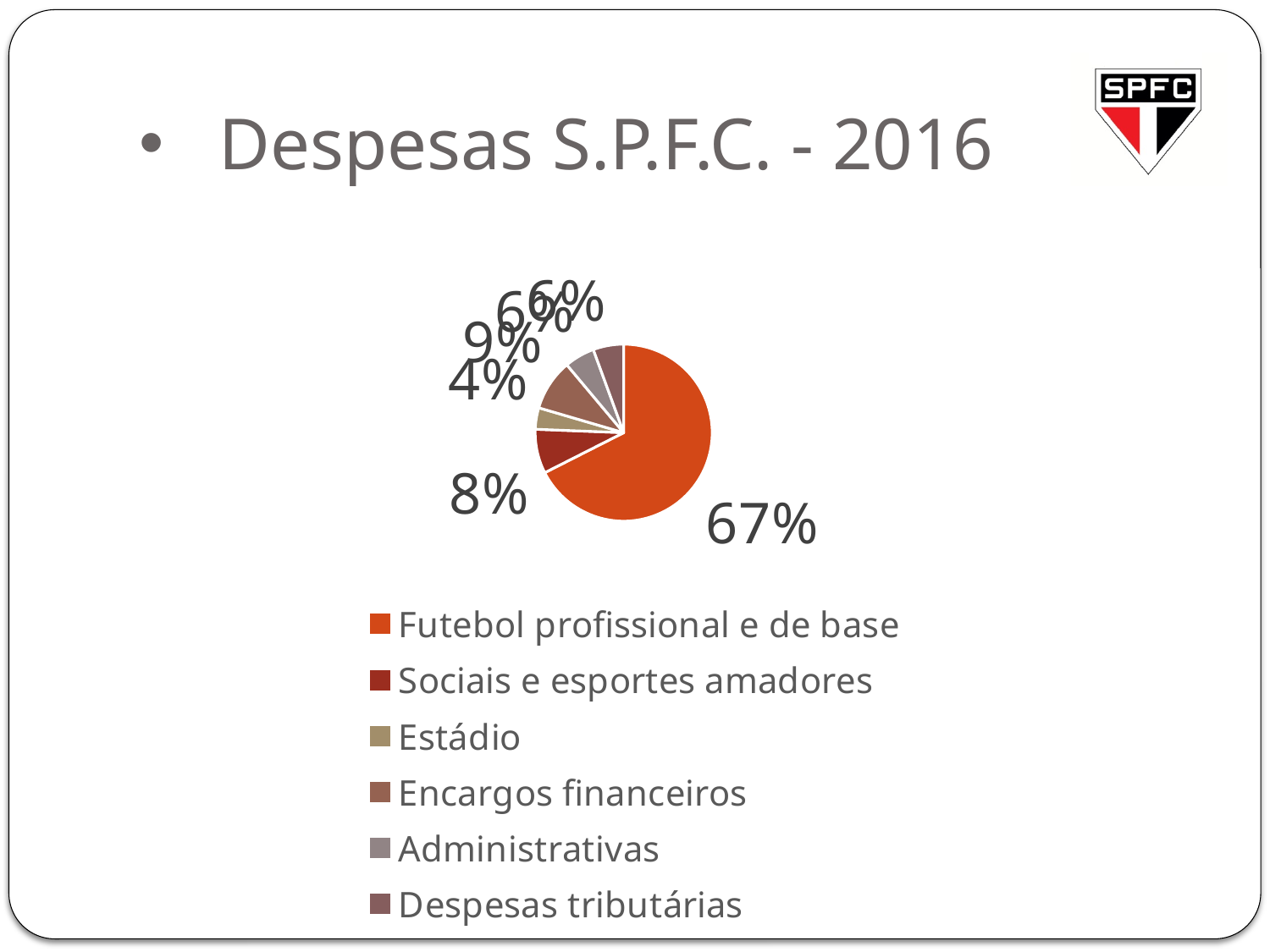
Which is larger, the share for Encargos financeiros or the share for Sociais e esportes amadores? Encargos financeiros What share of the pie does Estádio represent? 4% What colour is the slice for Futebol profissional e de base? orange What kind of chart is shown on the slide? pie chart What share of the pie does Encargos financeiros represent? 9% What share of the pie does Futebol profissional e de base represent? 67% Which category has the largest slice of the pie? Futebol profissional e de base How many categories does the legend list? 6 What is the title of the slide containing the chart? Despesas S.P.F.C. - 2016 What is the difference in percentage points between Futebol profissional e de base and Sociais e esportes amadores? 59 Which category has the smallest slice of the pie? Estádio